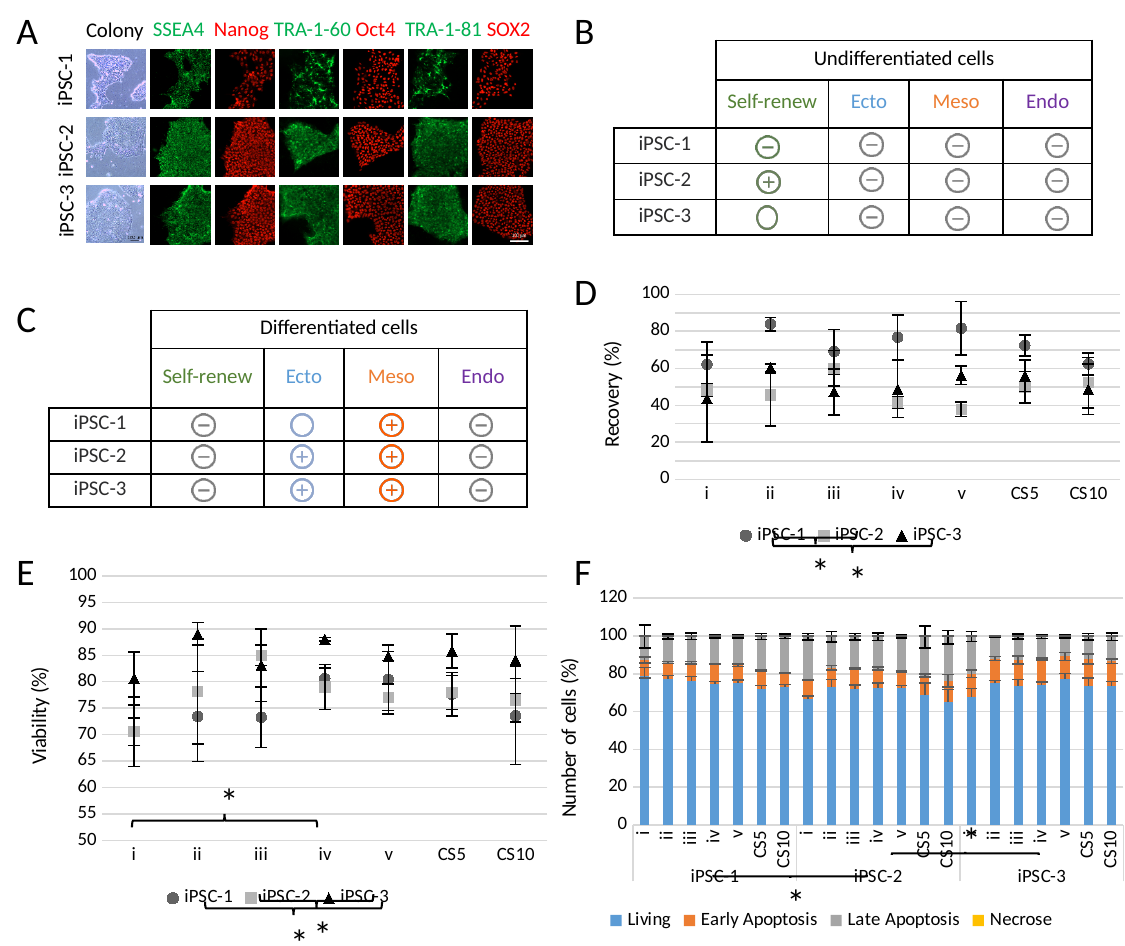
In chart D (Recovery (%)), which is larger at category ii, iPSC-1 or iPSC-2? iPSC-1 In chart D (Recovery (%)), is the value for iPSC-2 at ii greater or less than 60? less How many series does the legend of chart D (Recovery (%)) list? 3 How many categories are shown on the x axis of chart D (Recovery (%))? 7 How many series does the legend of chart F (Number of cells (%)) list? 4 What type of chart is chart F (Number of cells (%))? stacked bar chart What type of chart is chart D (Recovery (%))? scatter chart In chart E (Viability (%)), is the value for iPSC-3 at ii greater or less than 85? greater In chart E (Viability (%)), which is larger at category ii, iPSC-3 or iPSC-1? iPSC-3 In chart E (Viability (%)), is the value for iPSC-2 at i greater or less than 75? less What is the y-axis title of chart E? Viability (%)